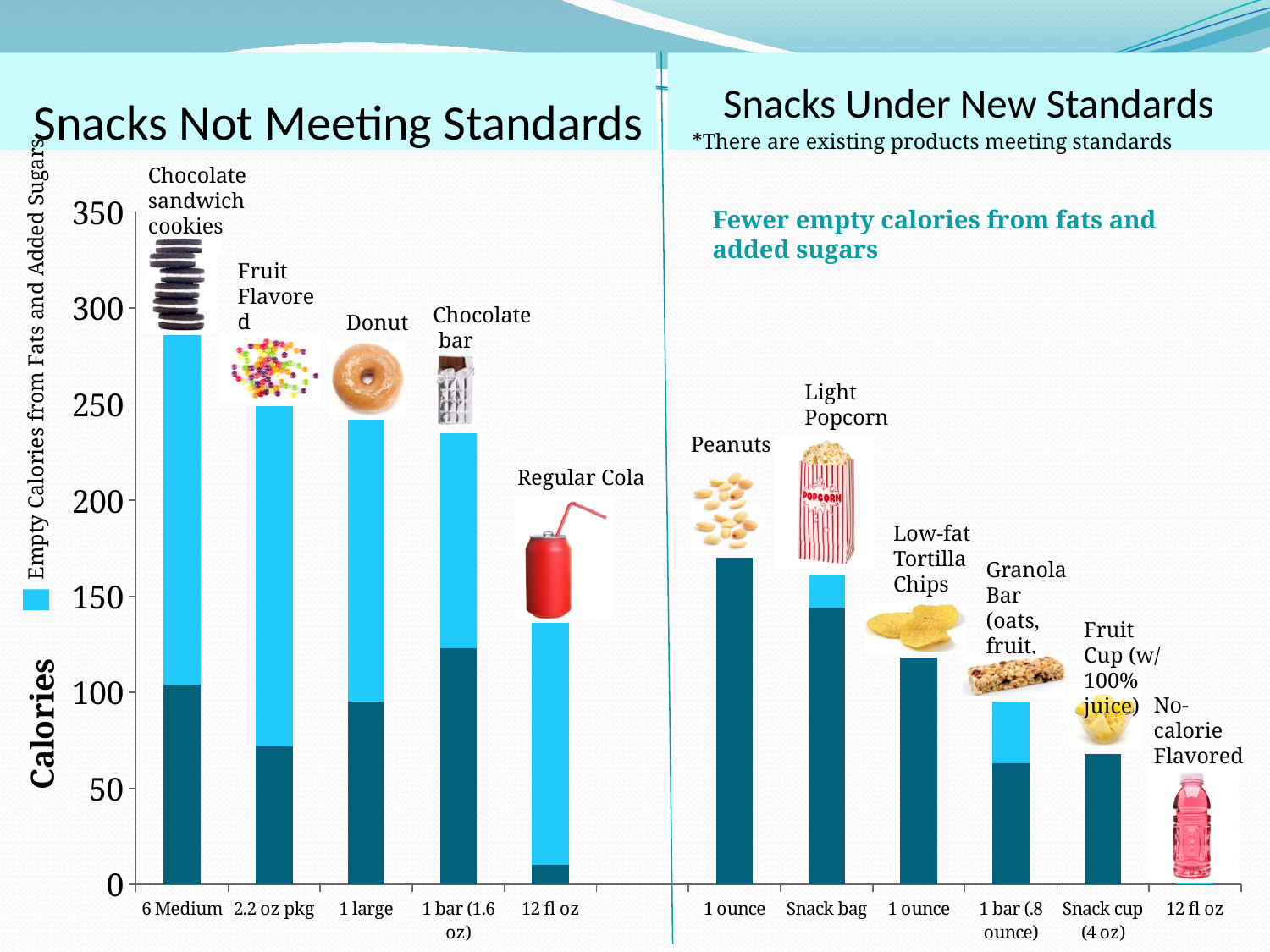
What kind of chart is shown on the slide? bar chart Which snack has the shortest bar on the chart? No-calorie Flavored Is the total value for Chocolate sandwich cookies greater or less than 250? greater Is the total value for Peanuts greater or less than 150? greater How many snacks are shown in the "Snacks Not Meeting Standards" section? 5 Is the total value for Low-fat Tortilla Chips greater or less than 100? greater What does the light blue portion of each bar represent, according to the legend? Empty Calories from Fats and Added Sugars Which has the larger total bar, Donut or Regular Cola? Donut How many bars are plotted in total across both sections of the chart? 11 Which snack has the tallest bar on the chart? Chocolate sandwich cookies In the "Snacks Under New Standards" section, do the bar totals rise or fall from left to right? fall